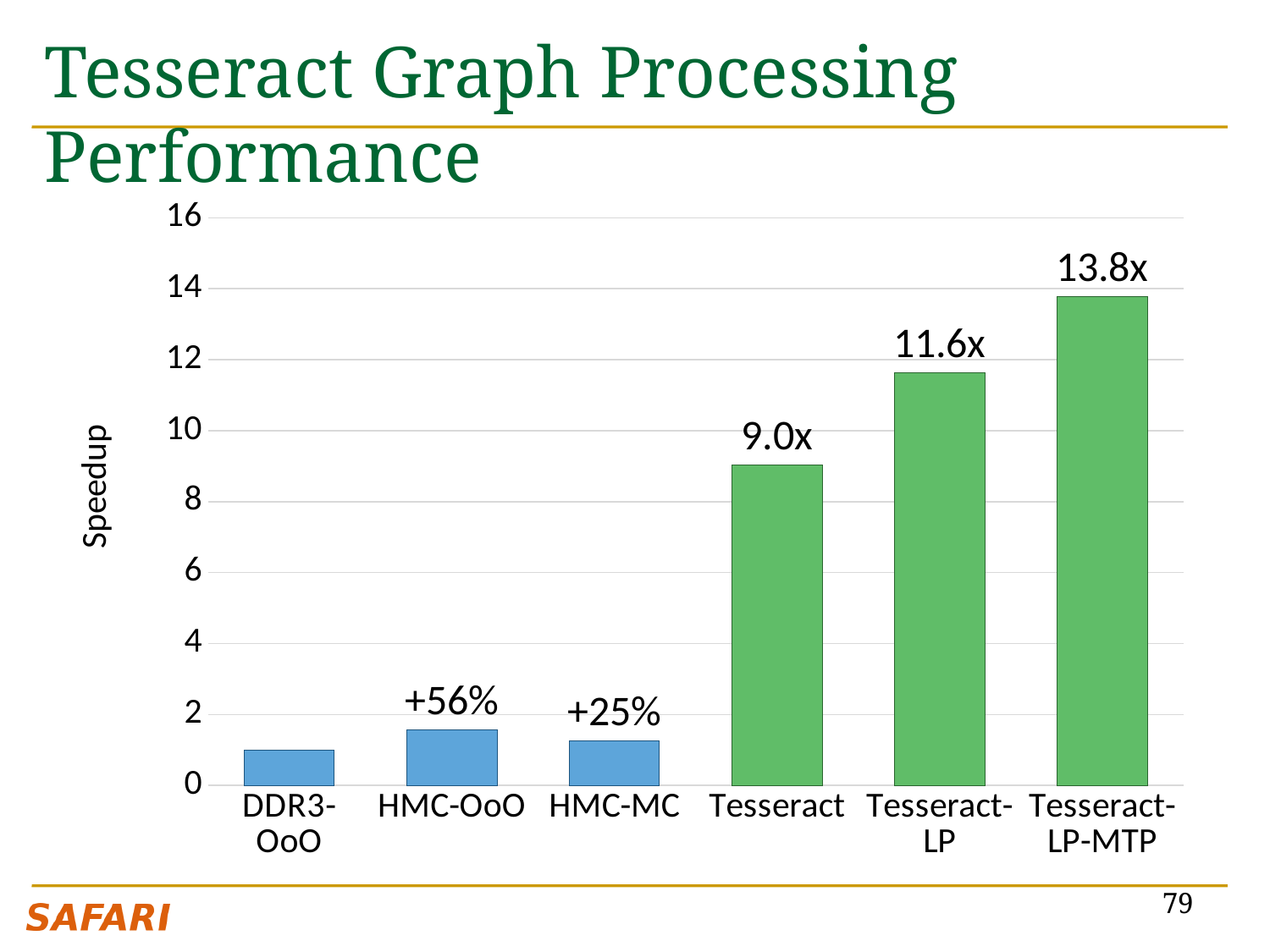
Which has a larger speedup, Tesseract or Tesseract-LP? Tesseract-LP What is the label of the y axis? Speedup Which category has the highest speedup? Tesseract-LP-MTP How many categories are shown on the x axis? 6 What is the data label shown on the Tesseract bar? 9.0x What is the difference between the labeled speedups of Tesseract-LP-MTP and Tesseract-LP? 2.2x Is the value for DDR3-OoO greater or less than 2? less What is the data label shown on the HMC-MC bar? +25% What kind of chart is shown on the slide? bar chart Which category has the lowest speedup? DDR3-OoO What is the data label shown on the Tesseract-LP-MTP bar? 13.8x What is the data label shown on the HMC-OoO bar? +56%